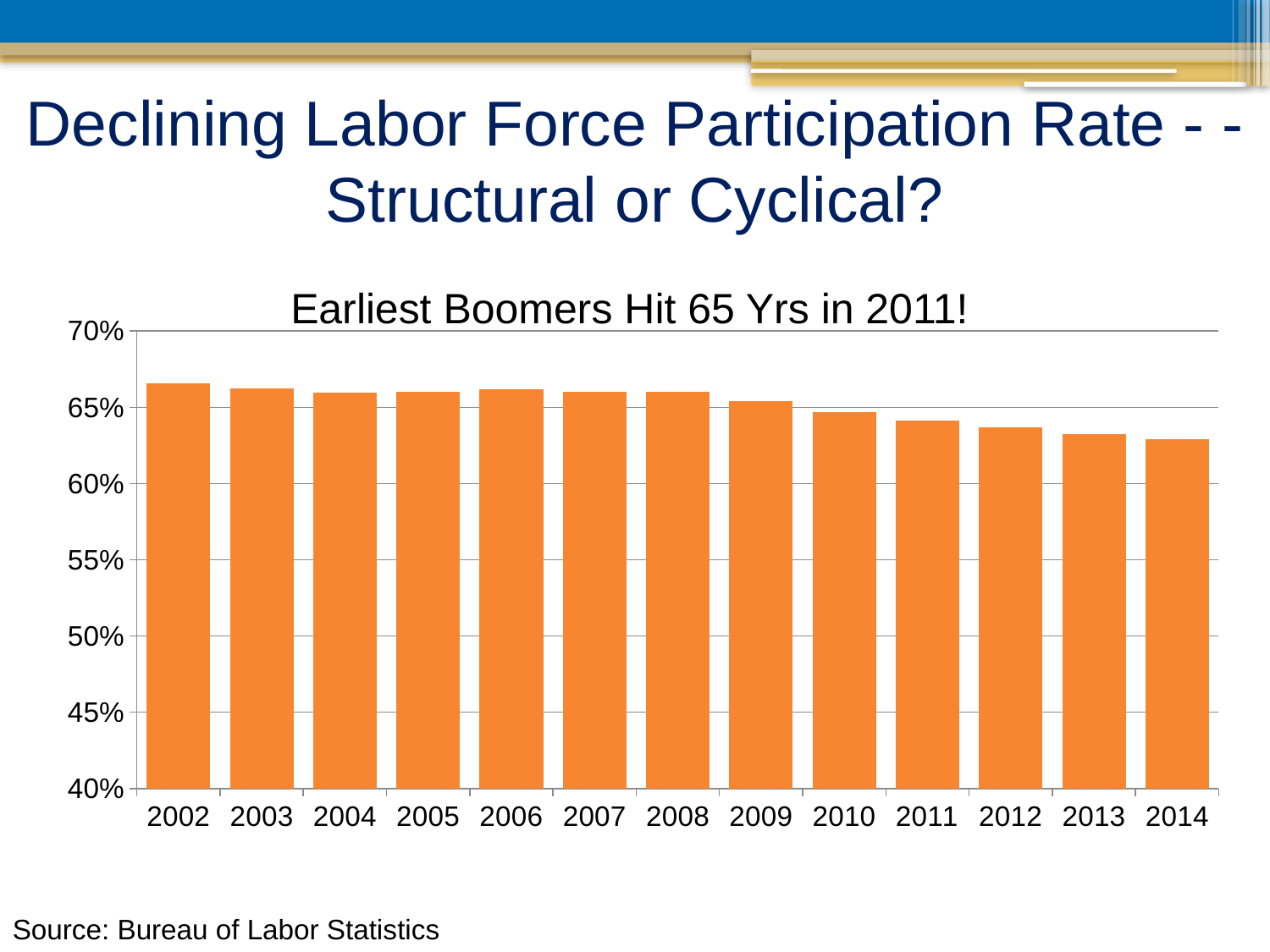
Which is larger, the value for 2002 or the value for 2014? 2002 Is the value for 2008 greater or less than 65%? greater How many years are shown on the x axis of the chart? 13 Is the value for 2014 greater or less than 65%? less Is the value for 2010 greater or less than 65%? less Do the values generally rise or fall from 2002 to 2014? fall What is the title of the chart? Earliest Boomers Hit 65 Yrs in 2011! Which is larger, the value for 2012 or the value for 2009? 2009 What kind of chart is shown on the slide? bar chart Which year has the lowest labor force participation rate in the chart? 2014